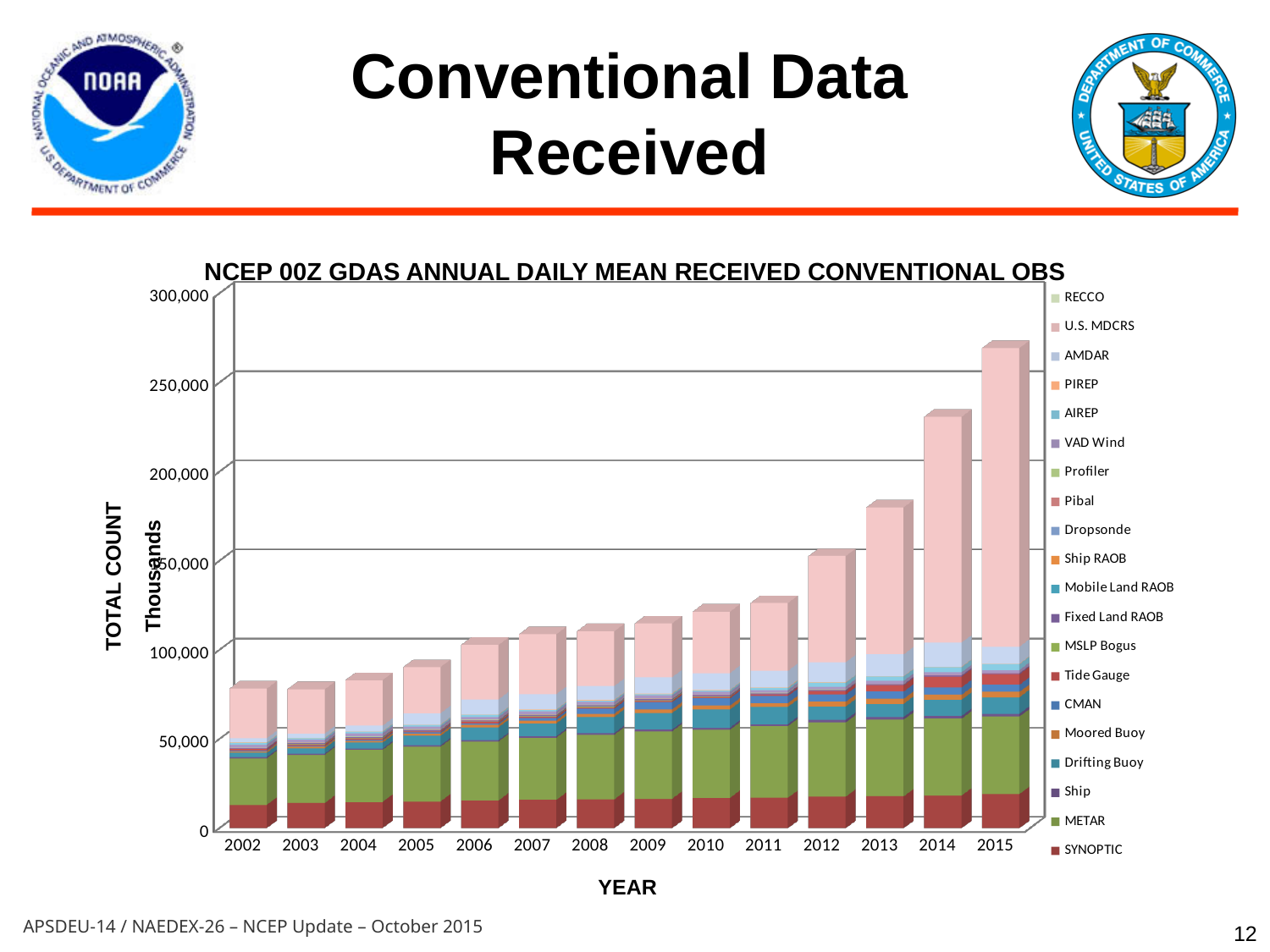
Do the total counts generally rise or fall from 2002 to 2015? Rise What is the title of the chart? NCEP 00Z GDAS ANNUAL DAILY MEAN RECEIVED CONVENTIONAL OBS How many years are shown along the x axis of the chart? 14 Which year has the highest total count in the chart? 2015 Which year has the larger total count, 2014 or 2015? 2015 How many series does the chart legend list? 20 What kind of chart is shown on the slide? Stacked bar chart Is the total for 2015 greater or less than 250,000? greater Is the total for 2014 greater or less than 200,000? greater Is the total for 2013 greater or less than 200,000? less